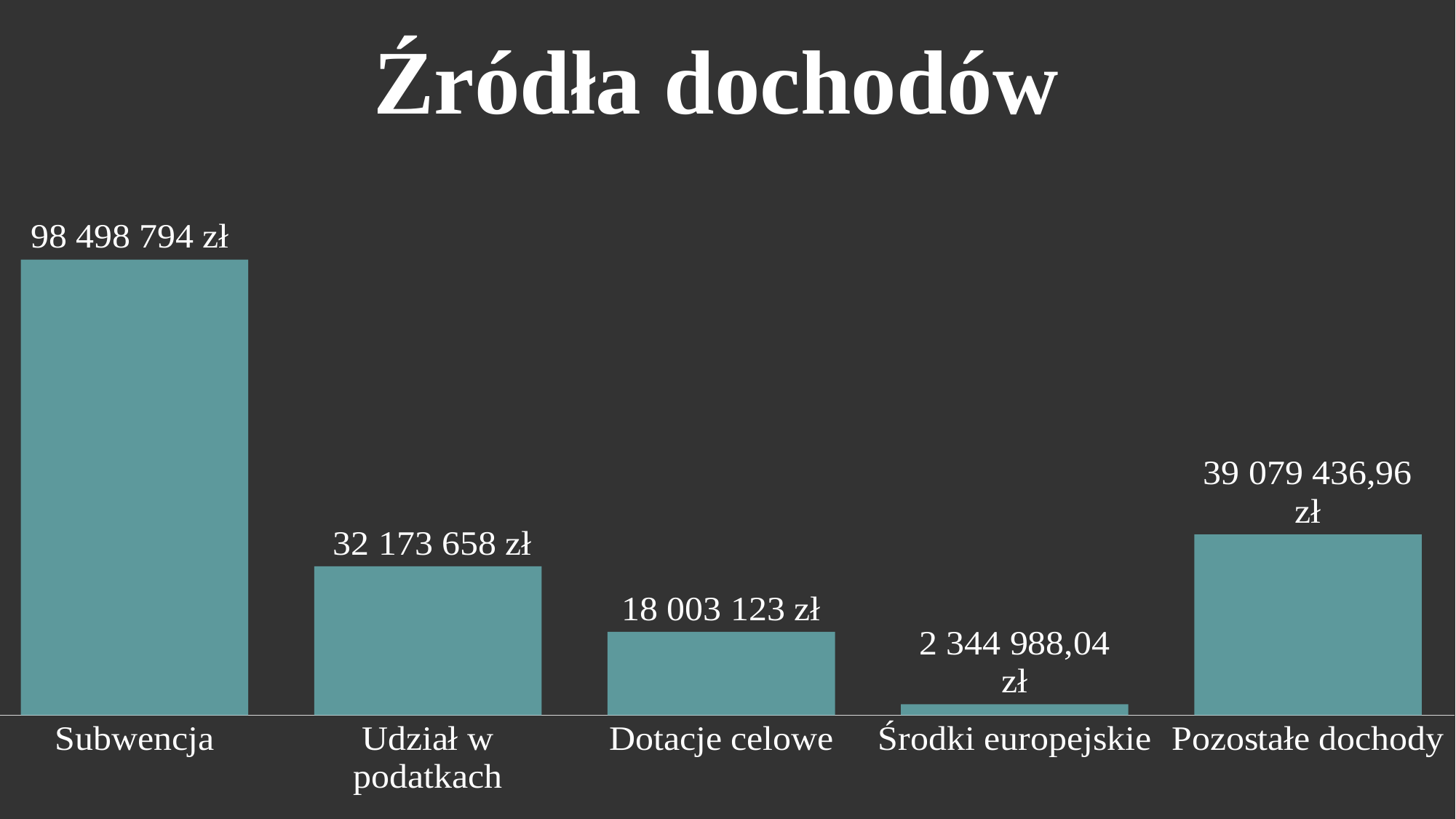
What is the difference between the values for Udział w podatkach and Dotacje celowe? 14 170 535 zł How many categories are shown in the chart? 5 What is the value for Pozostałe dochody? 39 079 436,96 zł What type of chart is shown on the slide? Bar chart What is the value for Środki europejskie? 2 344 988,04 zł Which is larger, the value for Pozostałe dochody or the value for Udział w podatkach? Pozostałe dochody What is the value for Dotacje celowe? 18 003 123 zł What is the value for Subwencja? 98 498 794 zł What is the value for Udział w podatkach? 32 173 658 zł Which category has the lowest value? Środki europejskie What is the difference between the values for Subwencja and Udział w podatkach? 66 325 136 zł Which category has the highest value? Subwencja